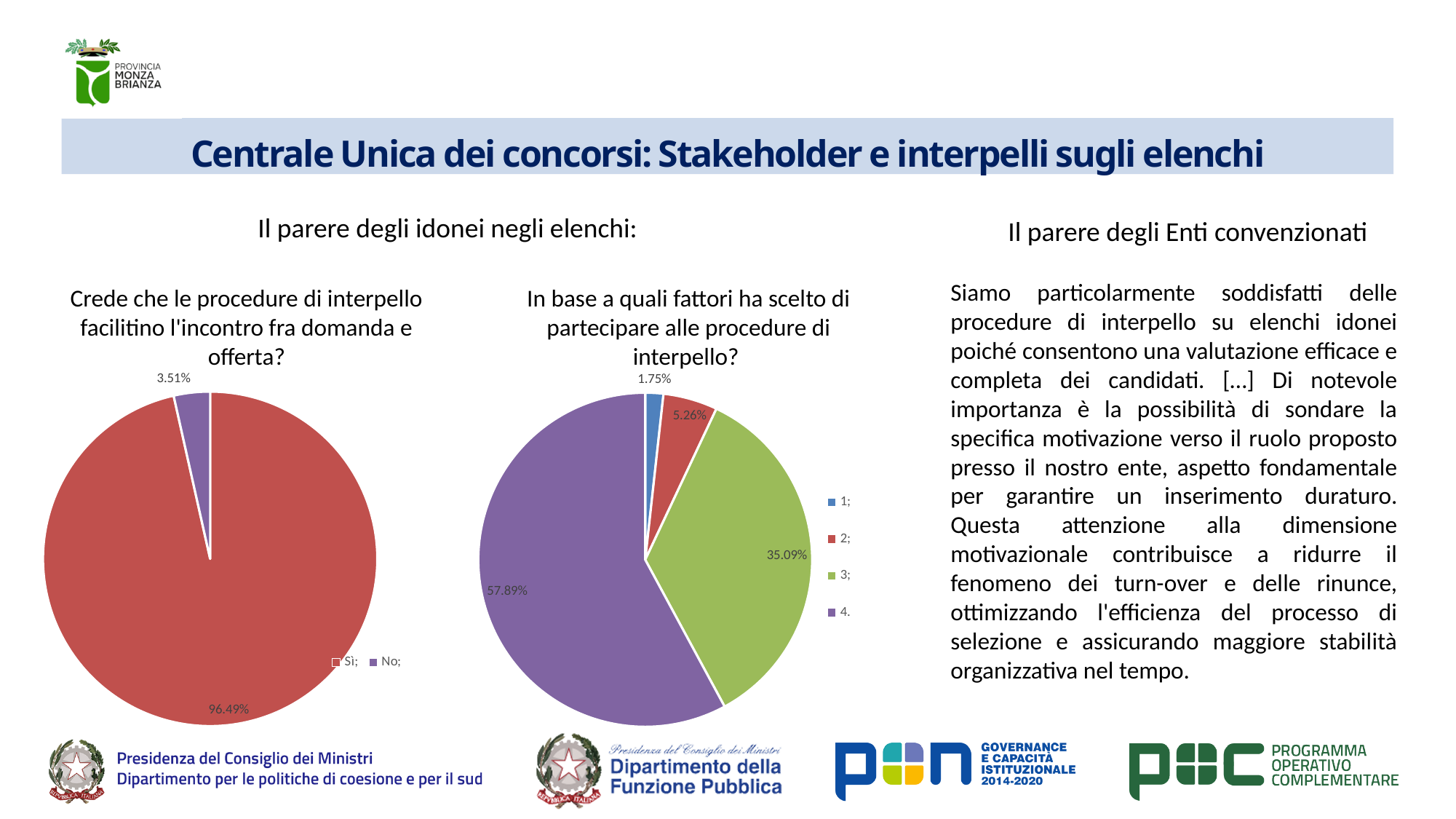
In the chart titled "Crede che le procedure di interpello facilitino l'incontro fra domanda e offerta?", what share of respondents answered No? 3.51% In the right pie chart, what is the difference between the shares of category 4 and category 3? 22.80% In the right pie chart, which category has the smallest share? 1 In the left pie chart, what is the difference between the Sì share and the No share? 92.98% In the chart titled "In base a quali fattori ha scelto di partecipare alle procedure di interpello?", what is the share for category 3? 35.09% In the chart titled "In base a quali fattori ha scelto di partecipare alle procedure di interpello?", what is the share for category 4? 57.89% In the chart titled "Crede che le procedure di interpello facilitino l'incontro fra domanda e offerta?", what share of respondents answered Sì? 96.49% In the right pie chart, how many categories are shown? 4 In the right pie chart, which category has the largest share? 4 In the chart titled "In base a quali fattori ha scelto di partecipare alle procedure di interpello?", what is the share for category 1? 1.75% In the right pie chart, which is larger: the share for category 2 or the share for category 3? 3 What kind of chart is used for "Crede che le procedure di interpello facilitino l'incontro fra domanda e offerta?"? Pie chart